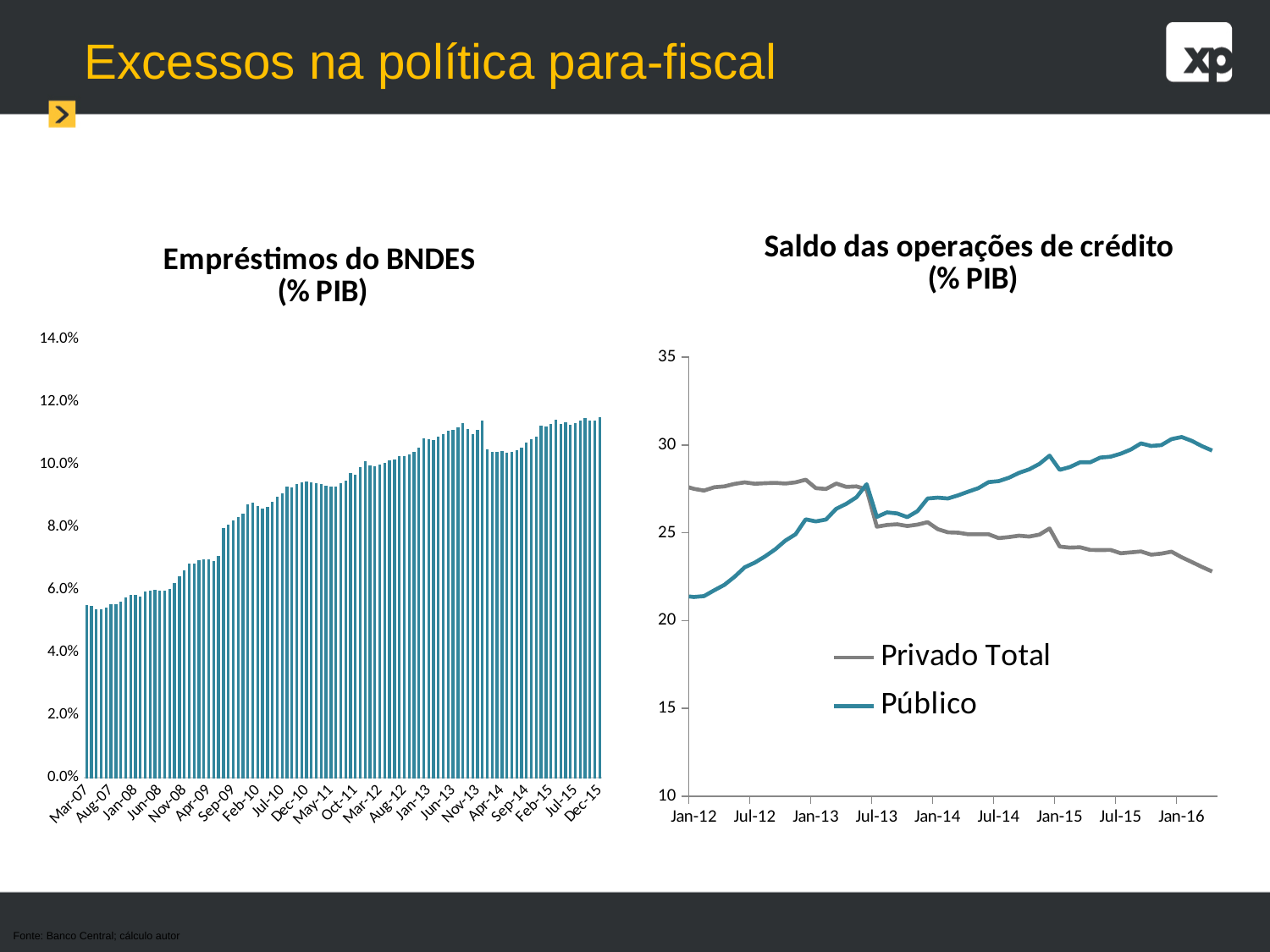
In the right chart "Saldo das operações de crédito (% PIB)", which series is higher at Jan-12, Privado Total or Público? Privado Total In the right chart "Saldo das operações de crédito (% PIB)", does the Público series rise or fall from Jan-12 to Jan-16? rise In the right chart "Saldo das operações de crédito (% PIB)", which series is higher at Jan-16, Privado Total or Público? Público In the right chart "Saldo das operações de crédito (% PIB)", what are the two series named in the legend? Privado Total and Público In the right chart "Saldo das operações de crédito (% PIB)", does the Privado Total series rise or fall from Jan-14 to Jan-16? fall In the left chart "Empréstimos do BNDES (% PIB)", is the value for Mar-07 greater or less than 6.0%? less In the right chart "Saldo das operações de crédito (% PIB)", is the Público value at Jan-12 greater or less than 25? less What kind of chart is the right chart titled "Saldo das operações de crédito (% PIB)"? line chart What kind of chart is the left chart titled "Empréstimos do BNDES (% PIB)"? bar chart In the left chart "Empréstimos do BNDES (% PIB)", do the values generally rise or fall from Mar-07 to Dec-15? rise In the right chart "Saldo das operações de crédito (% PIB)", how many series does the legend list? 2 In the left chart "Empréstimos do BNDES (% PIB)", is the value for Dec-15 greater or less than 10.0%? greater